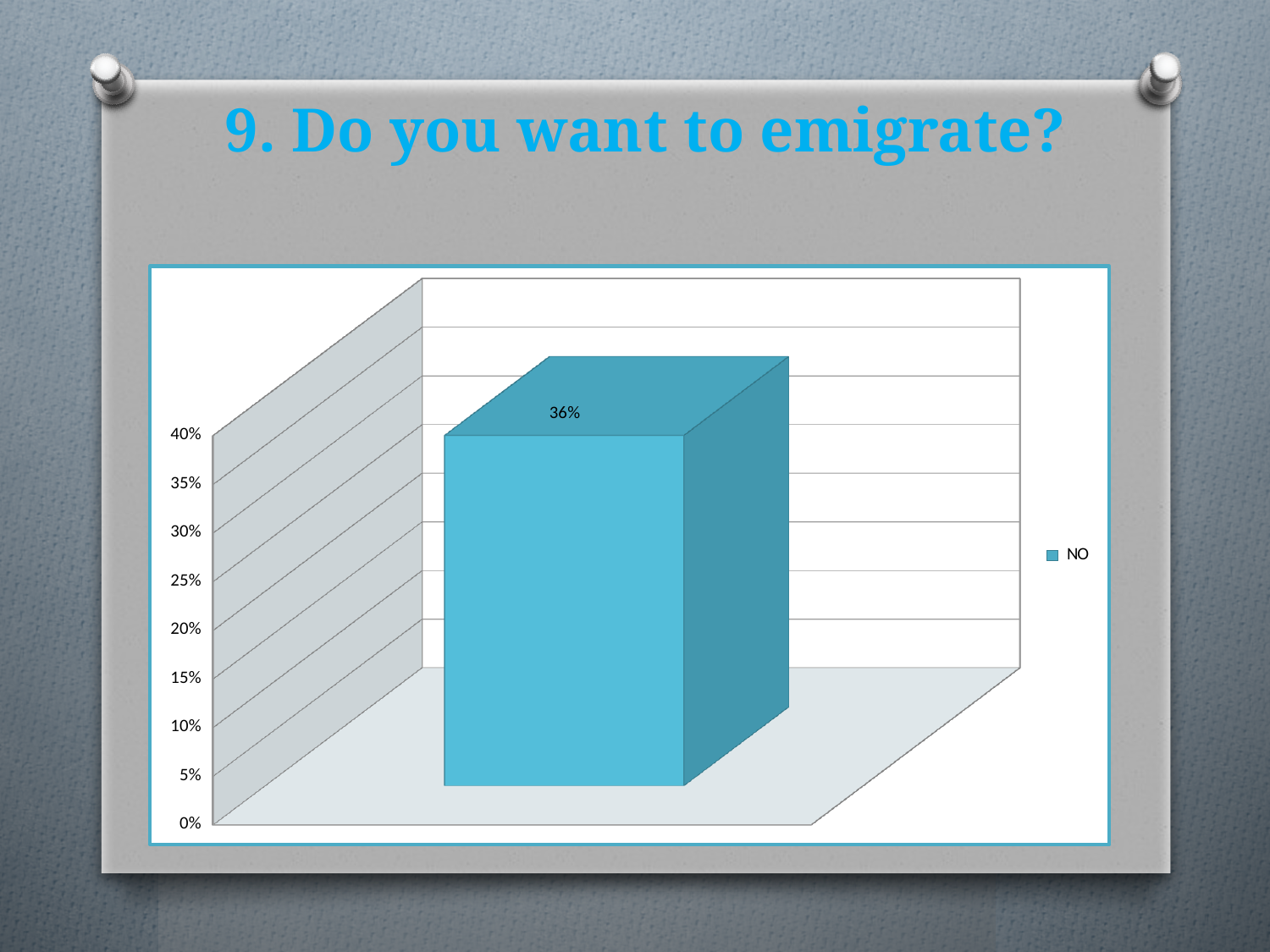
Is the value for NO greater or less than 40%? less What is the value shown for the NO bar? 36% How many series does the legend list? 1 What is the title of the slide containing the chart? 9. Do you want to emigrate? What is the highest value labelled on the vertical axis? 40% Is the value for NO greater or less than 30%? greater What kind of chart is shown on the slide? bar chart What series name appears in the chart legend? NO How many bars are plotted in the chart? 1